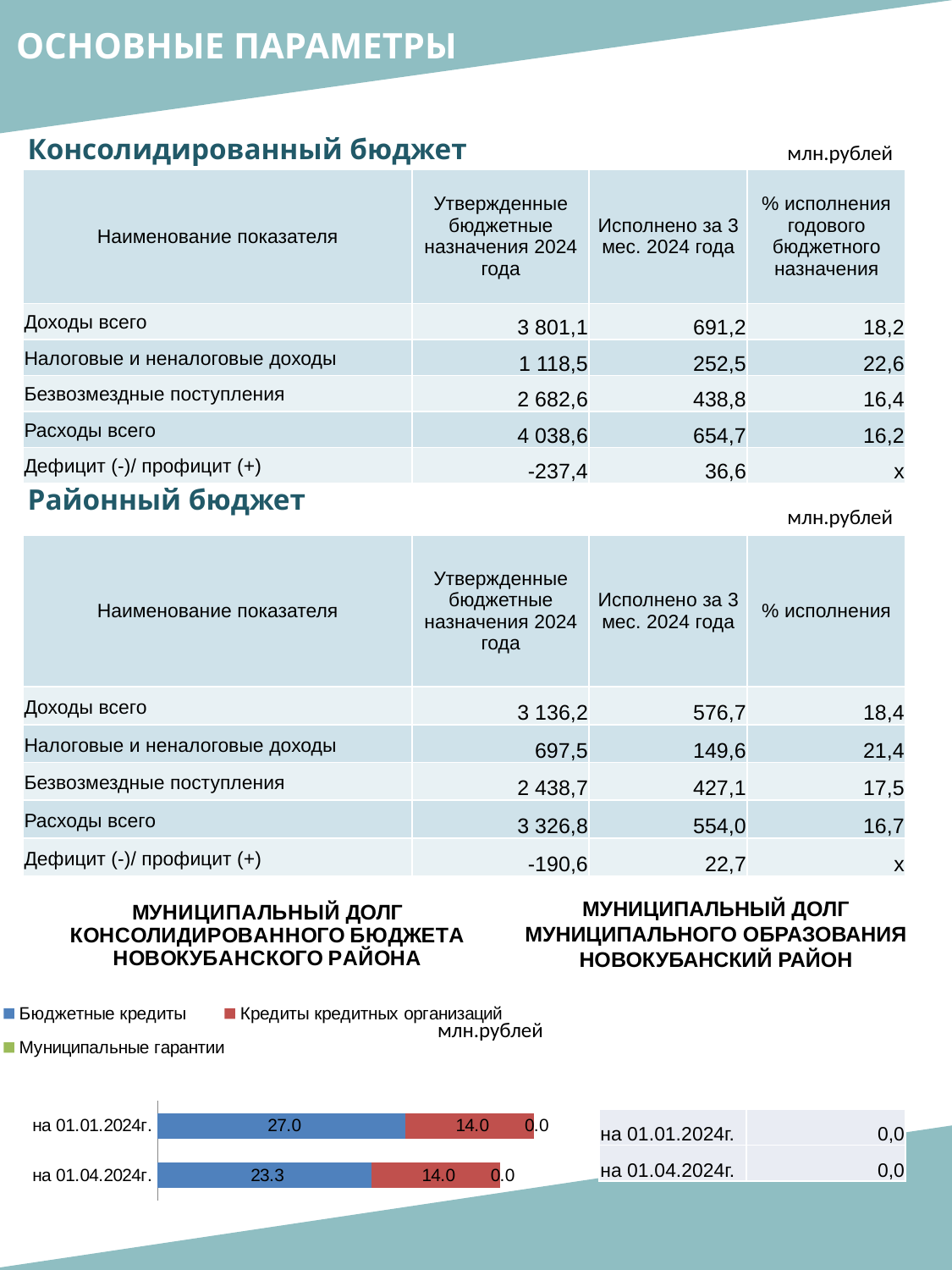
What is the difference between Бюджетные кредиты on 01.01.2024г. and on 01.04.2024г.? 3.7 What is the total of the stacked bar for на 01.04.2024г.? 37.3 What is the value of Бюджетные кредиты for на 01.04.2024г.? 23.3 What is the value of Кредиты кредитных организаций for на 01.04.2024г.? 14.0 What kind of chart is shown on the slide? bar chart What is the total of the stacked bar for на 01.01.2024г.? 41.0 How many categories (dates) are plotted in the chart? 2 Which date has the larger value for Бюджетные кредиты, на 01.01.2024г. or на 01.04.2024г.? на 01.01.2024г. How many series does the chart legend list? 3 Which legend entry is shown in red in the chart? Кредиты кредитных организаций What is the value of Муниципальные гарантии for на 01.01.2024г.? 0.0 What is the value of Бюджетные кредиты for на 01.01.2024г.? 27.0